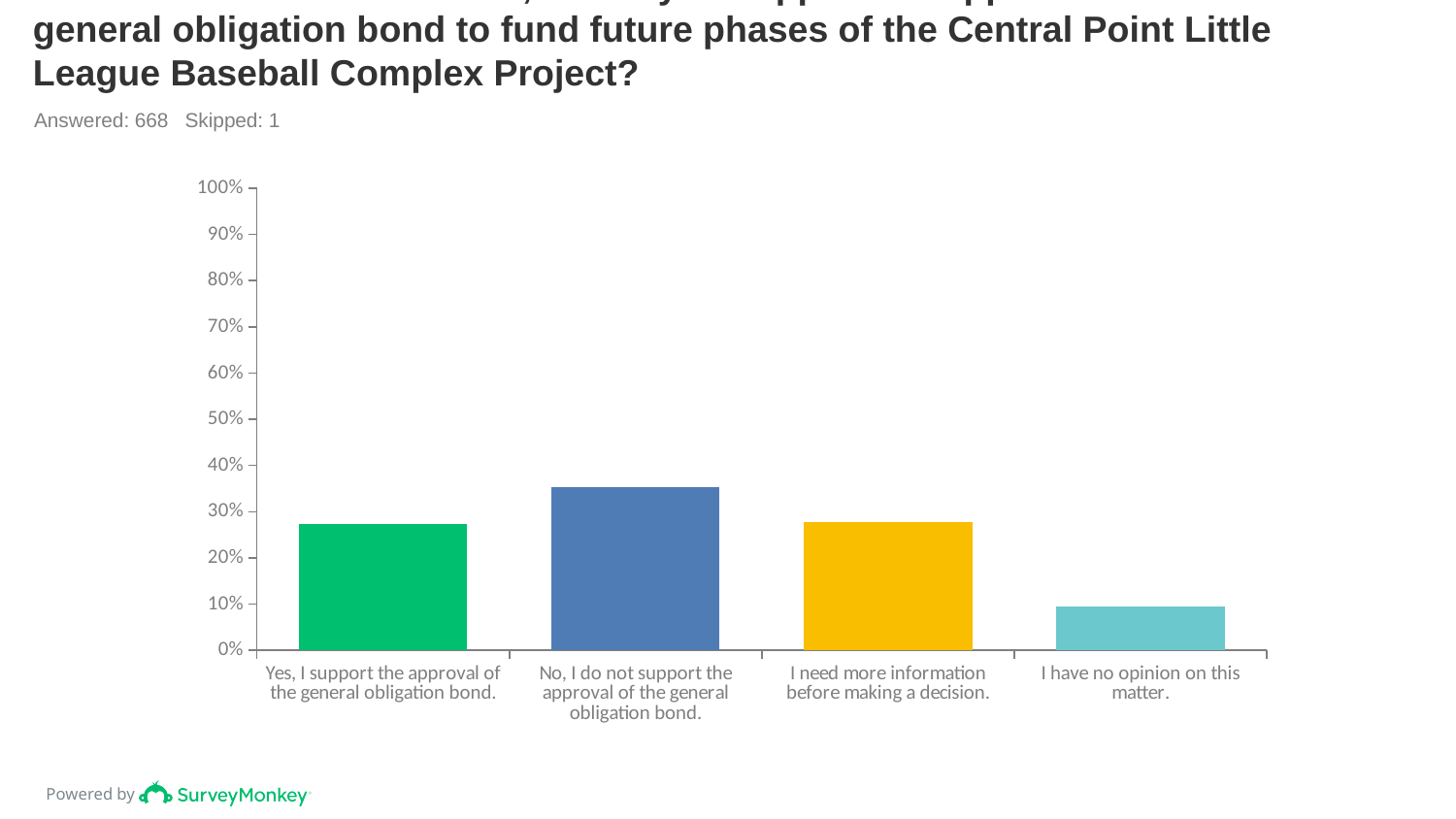
What kind of chart is shown on the slide? bar chart Is the value for "Yes, I support the approval of the general obligation bond." greater or less than 20%? greater Is the value for "No, I do not support the approval of the general obligation bond." greater or less than 40%? less Is the value for "I need more information before making a decision." greater or less than 30%? less Which response category has the highest value? No, I do not support the approval of the general obligation bond. Which is larger: the value for "No, I do not support the approval of the general obligation bond." or the value for "I have no opinion on this matter."? No, I do not support the approval of the general obligation bond. What colour is the bar for "No, I do not support the approval of the general obligation bond."? blue How many respondents answered the question according to the slide? 668 How many response categories are shown on the chart? 4 Which response category has the lowest value? I have no opinion on this matter.